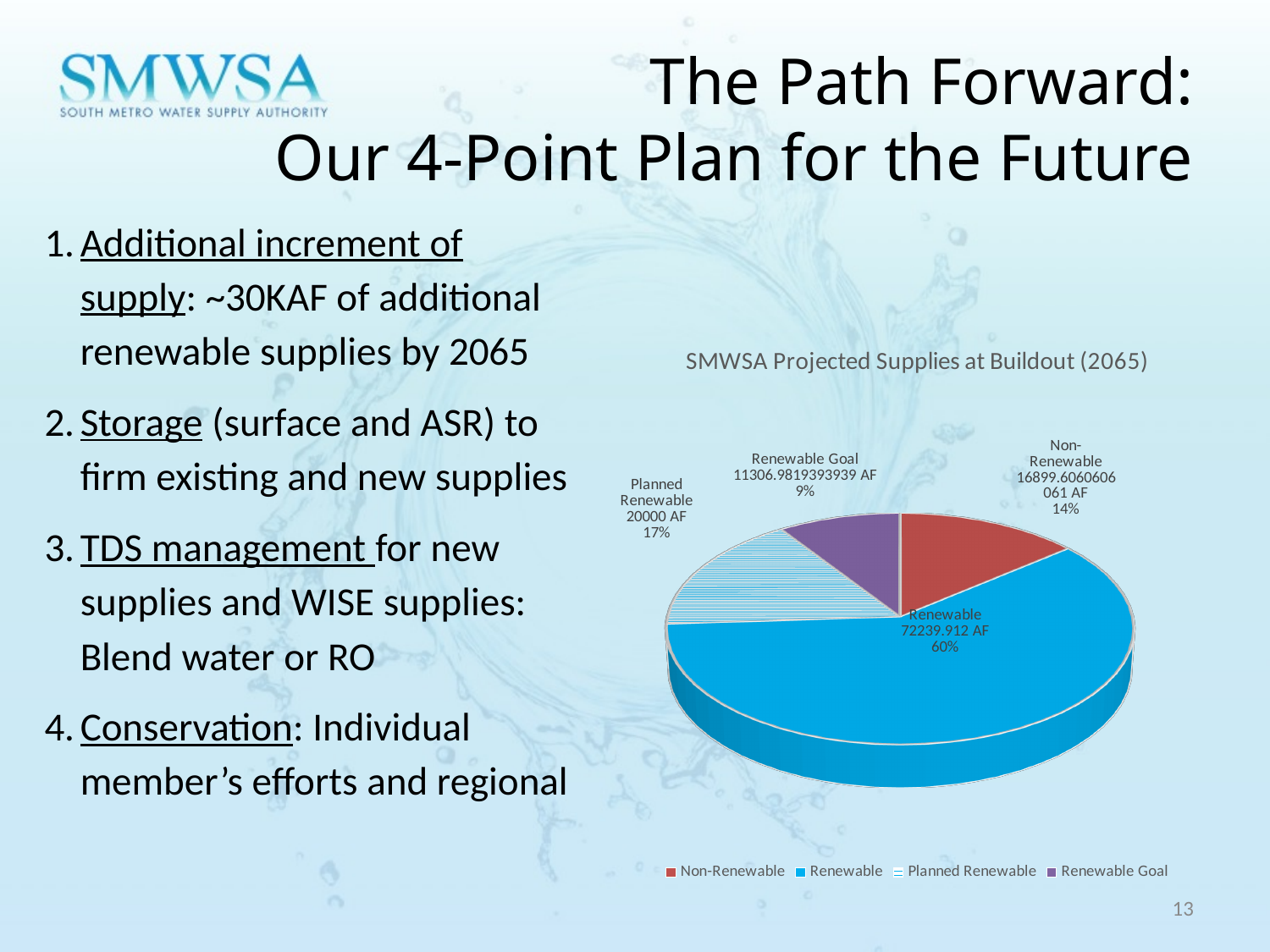
How many entries does the legend of the pie chart list? 4 What share of the pie does the Non-Renewable slice represent? 14% What share of the pie does the Renewable Goal slice represent? 9% What kind of chart is shown on the slide? Pie chart What is the value labelled for the Planned Renewable slice? 20000 AF How many slices does the pie chart have? 4 Which slice of the pie chart is the smallest? Renewable Goal What is the value labelled for the Renewable slice? 72239.912 AF What is the title of the pie chart? SMWSA Projected Supplies at Buildout (2065) Which slice of the pie chart is the largest? Renewable What share of the pie does the Planned Renewable slice represent? 17%